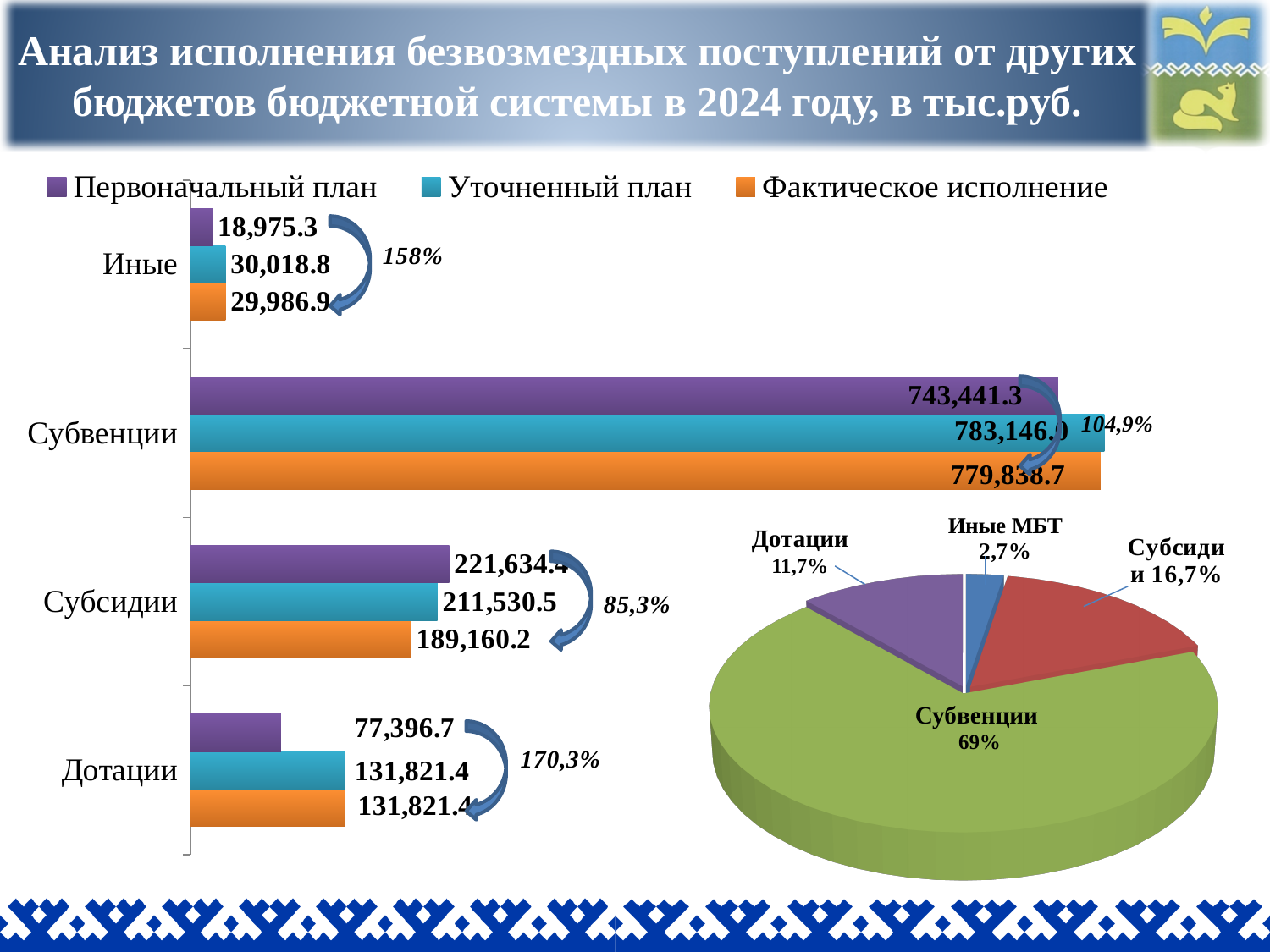
In the bar chart, which category has the lowest Первоначальный план value? Иные In the bar chart, which is larger for Иные: the Уточненный план value or the Фактическое исполнение value? Уточненный план In the bar chart, what is the Первоначальный план value for Субвенции? 743,441.3 In the bar chart, what is the Уточненный план value for Субсидии? 211,530.5 In the pie chart, which slice is the smallest? Иные МБТ In the bar chart, what is the Первоначальный план value for Иные? 18,975.3 In the pie chart, what share does Субвенции have? 69% In the bar chart, what is the difference between the Уточненный план and Фактическое исполнение values for Субсидии? 22,370.3 What kind of chart is the chart on the right side of the slide? Pie chart How many series does the bar chart's legend list? 3 In the bar chart, which category has the highest Фактическое исполнение value? Субвенции In the bar chart, what is the Фактическое исполнение value for Дотации? 131,821.4